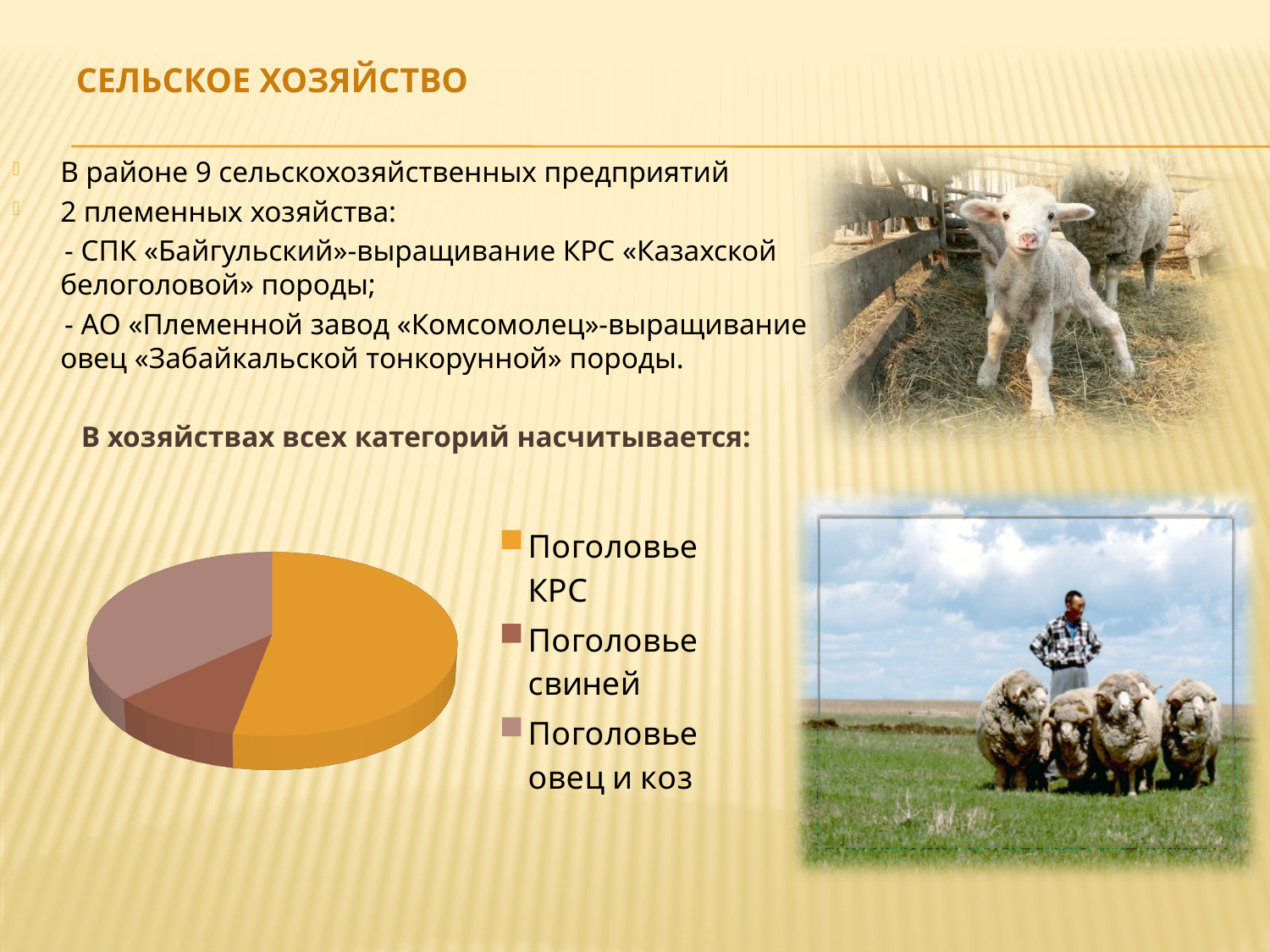
How many slices does the pie chart have? 3 How many entries does the legend of the pie chart list? 3 Which slice is larger in the pie chart: Поголовье свиней or Поголовье овец и коз? Поголовье овец и коз Which category has the largest slice in the pie chart? Поголовье КРС Which slice is larger in the pie chart: Поголовье КРС or Поголовье овец и коз? Поголовье КРС What kind of chart is shown on the slide? Pie chart Which legend entry is listed first in the pie chart's legend? Поголовье КРС What colour is the slice for Поголовье КРС in the pie chart? Orange Which slice is smaller in the pie chart: Поголовье КРС or Поголовье свиней? Поголовье свиней Which category has the smallest slice in the pie chart? Поголовье свиней